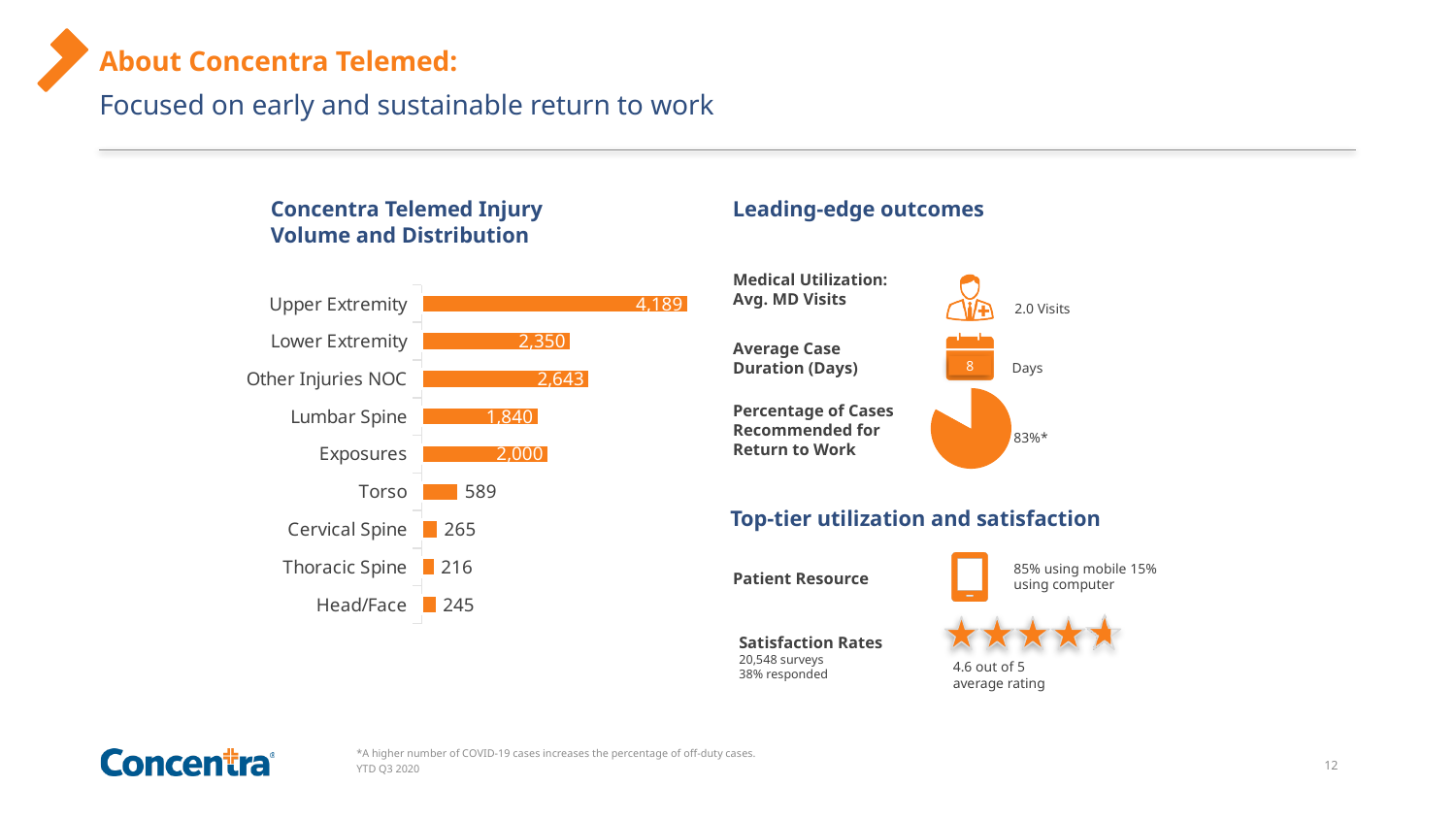
What is the difference between Other Injuries NOC and Lower Extremity in the injury volume chart? 293 Which category has the lowest value in the injury volume chart? Thoracic Spine What colour are the bars in the injury volume chart? Orange What is the value for Upper Extremity in the Concentra Telemed Injury Volume and Distribution chart? 4,189 Which is larger in the injury volume chart, Torso or Head/Face? Torso Which category has the highest value in the injury volume chart? Upper Extremity Which is larger in the injury volume chart, Lumbar Spine or Exposures? Exposures How many categories are shown in the injury volume chart? 9 What is the value for Thoracic Spine in the injury volume chart? 216 What is the value for Exposures in the injury volume chart? 2,000 What kind of chart is the Concentra Telemed Injury Volume and Distribution chart? Bar chart What is the difference between Upper Extremity and Lumbar Spine in the injury volume chart? 2,349